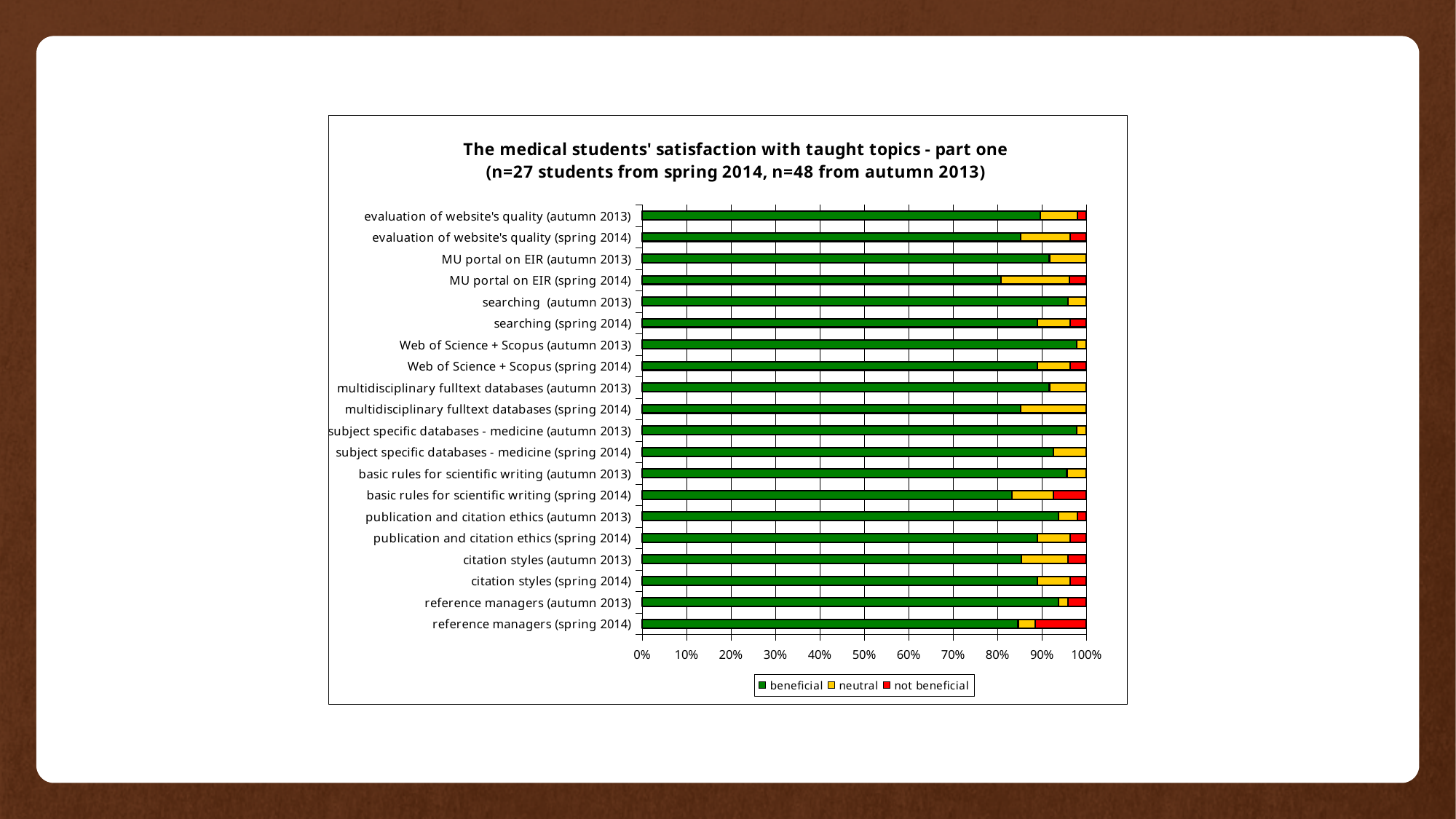
How many series does the legend list? 3 What is the title of the chart? The medical students' satisfaction with taught topics - part one (n=27 students from spring 2014, n=48 from autumn 2013) Which series is shown in red in the legend? not beneficial Which has the larger 'beneficial' share: searching (autumn 2013) or searching (spring 2014)? searching (autumn 2013) Is the 'beneficial' share for reference managers (spring 2014) greater or less than 80%? greater What do the three segments of each bar add up to? 100% How many categories (bars) are plotted on the chart? 20 Is the 'beneficial' share for basic rules for scientific writing (spring 2014) greater or less than 90%? less Is the 'beneficial' share for Web of Science + Scopus (autumn 2013) greater or less than 90%? greater What kind of chart is shown on the slide? stacked bar chart Which category has the largest 'not beneficial' share? reference managers (spring 2014)